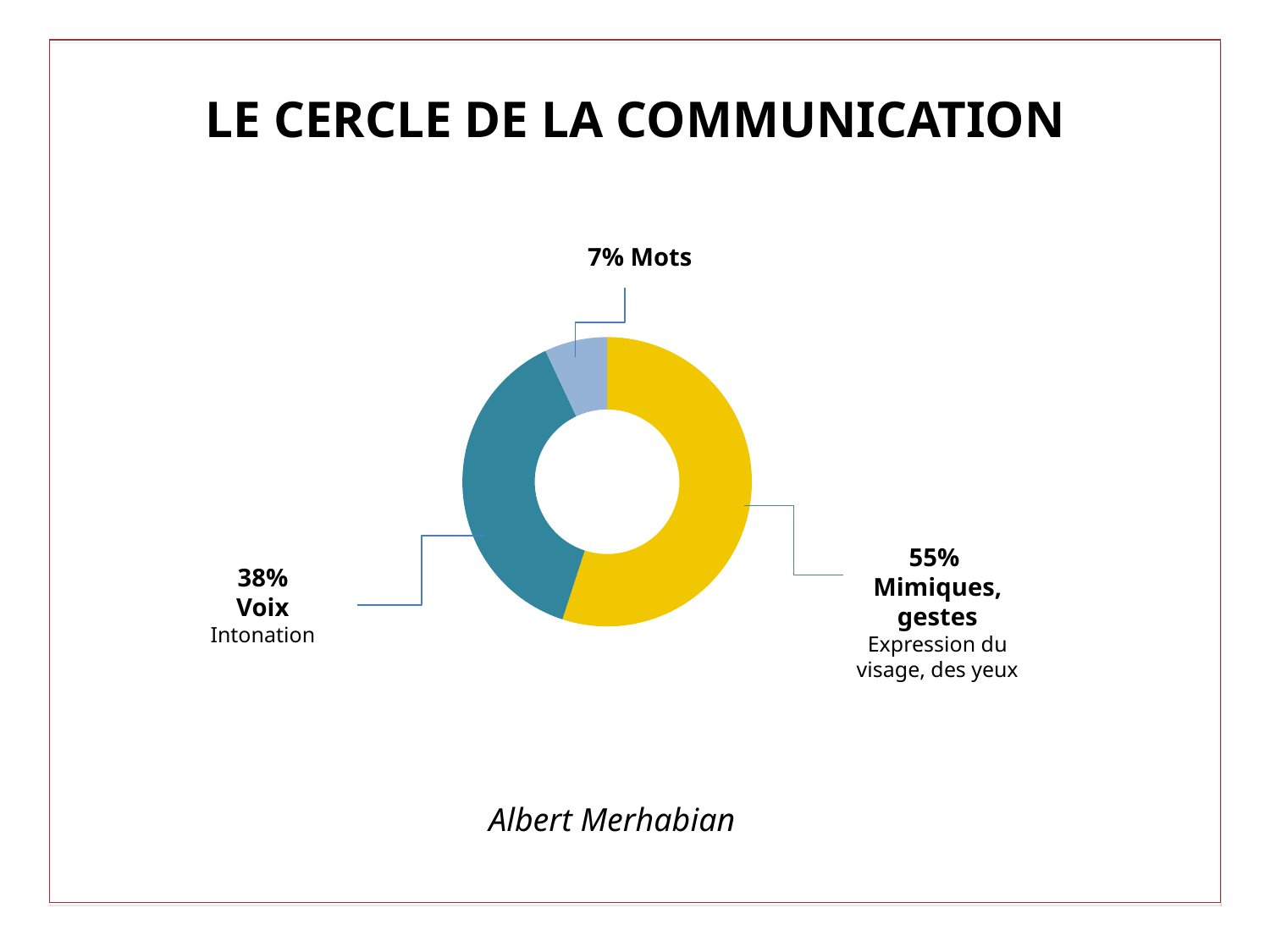
What colour is the segment representing "Voix"? Teal How many categories are shown in the chart? 3 Which is larger, the share for "Voix" or the share for "Mots"? Voix What is the difference in percentage points between "Voix" and "Mots"? 31 What kind of chart is shown on the slide? Doughnut chart Which category has the smallest share of the chart? Mots What is the title of the slide containing the chart? LE CERCLE DE LA COMMUNICATION What share of the chart is labelled "Mimiques, gestes"? 55% What share of the chart is labelled "Voix"? 38% What is the difference in percentage points between "Mimiques, gestes" and "Voix"? 17 Which category has the largest share of the chart? Mimiques, gestes What share of the chart is labelled "Mots"? 7%